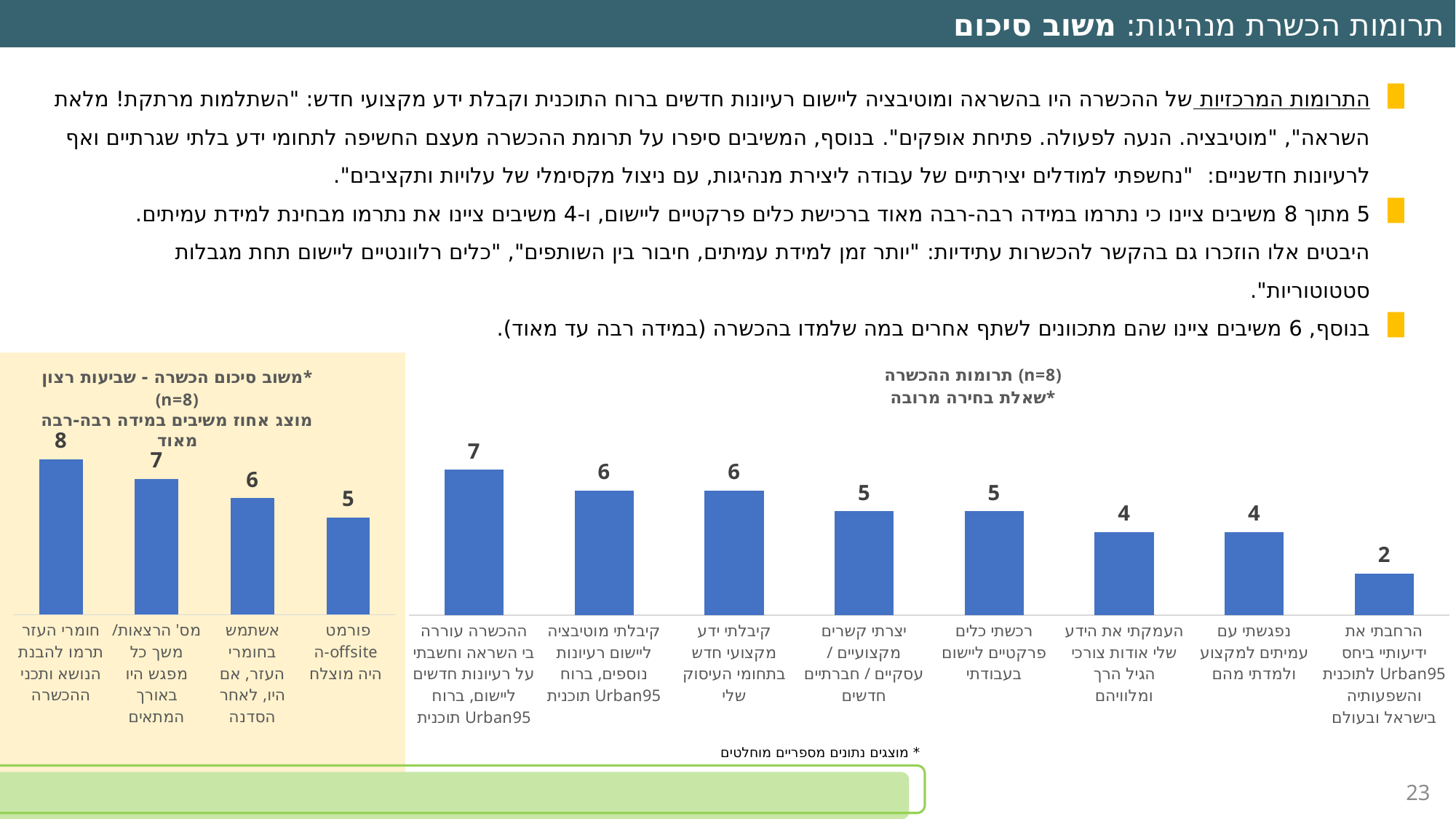
In the chart titled 'תרומות ההכשרה (n=8)', which is larger: the value for 'יצרתי קשרים מקצועיים / עסקיים / חברתיים חדשים' or the value for 'העמקתי את הידע שלי אודות צורכי הגיל הרך ומלוויהם'? יצרתי קשרים מקצועיים / עסקיים / חברתיים חדשים In the chart on the left titled 'משוב סיכום הכשרה - שביעות רצון (n=8)', what is the value for 'חומרי העזר תרמו להבנת הנושא ותכני ההכשרה'? 8 In the chart titled 'תרומות ההכשרה (n=8)', what is the value for 'רכשתי כלים פרקטיים ליישום בעבודתי'? 5 In the chart on the left titled 'משוב סיכום הכשרה - שביעות רצון (n=8)', how many categories are plotted? 4 In the chart titled 'תרומות ההכשרה (n=8)', which category has the lowest value? הרחבתי את ידיעותיי ביחס לתוכנית Urban95 והשפעותיה בישראל ובעולם In the chart on the left titled 'משוב סיכום הכשרה - שביעות רצון (n=8)', what is the value for 'פורמט ה-offsite היה מוצלח'? 5 In the chart on the left titled 'משוב סיכום הכשרה - שביעות רצון (n=8)', which category has the lowest value? פורמט ה-offsite היה מוצלח In the chart titled 'תרומות ההכשרה (n=8)', which category has the highest value? ההכשרה עוררה בי השראה וחשבתי על רעיונות חדשים ליישום, ברוח תוכנית Urban95 In the chart titled 'תרומות ההכשרה (n=8)', what is the value for 'ההכשרה עוררה בי השראה וחשבתי על רעיונות חדשים ליישום, ברוח תוכנית Urban95'? 7 In the chart titled 'תרומות ההכשרה (n=8)', what is the difference between the value for 'קיבלתי ידע מקצועי חדש בתחומי העיסוק שלי' and the value for 'נפגשתי עם עמיתים למקצוע ולמדתי מהם'? 2 In the chart titled 'תרומות ההכשרה (n=8)', how many categories are plotted? 8 What type of chart is the chart titled 'תרומות ההכשרה (n=8)'? bar chart